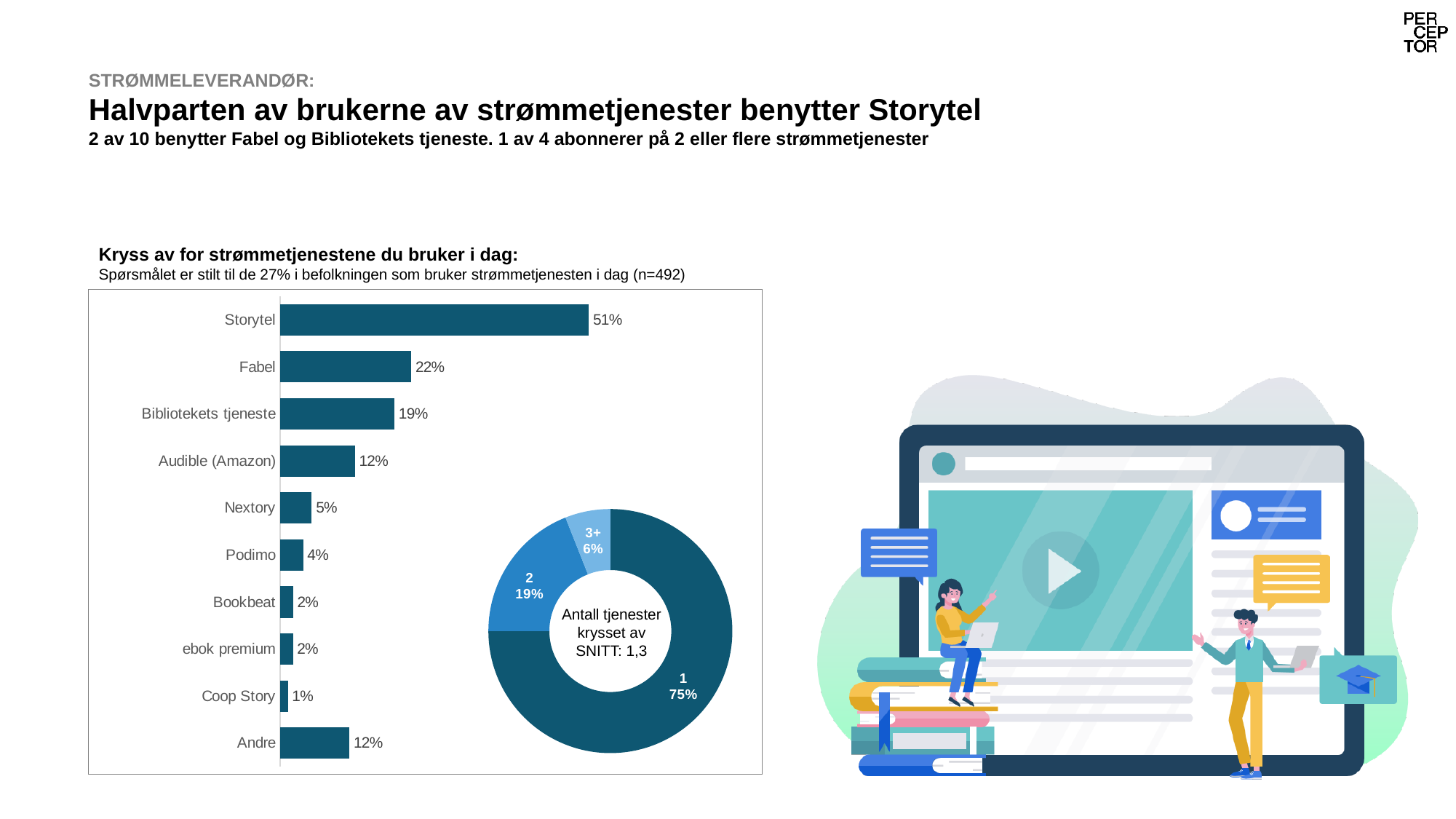
In the donut chart, what share of respondents use exactly 1 service? 75% In the bar chart, which is larger: Fabel or Bibliotekets tjeneste? Fabel In the donut chart, what share of respondents use 3 or more services? 6% In the bar chart, which streaming service has the highest share of users? Storytel In the bar chart, what is the difference between Fabel and Audible (Amazon)? 10 percentage points How many categories are shown in the bar chart? 10 What is the average number of services ticked, as shown in the centre of the donut chart? 1,3 In the bar chart, what is the value for Bibliotekets tjeneste? 19% In the bar chart, what is the value for Nextory? 5% In the bar chart, which named service has the lowest value? Coop Story In the bar chart, what percentage of users use Storytel? 51% What type of chart is used to show the streaming services on the left? Bar chart